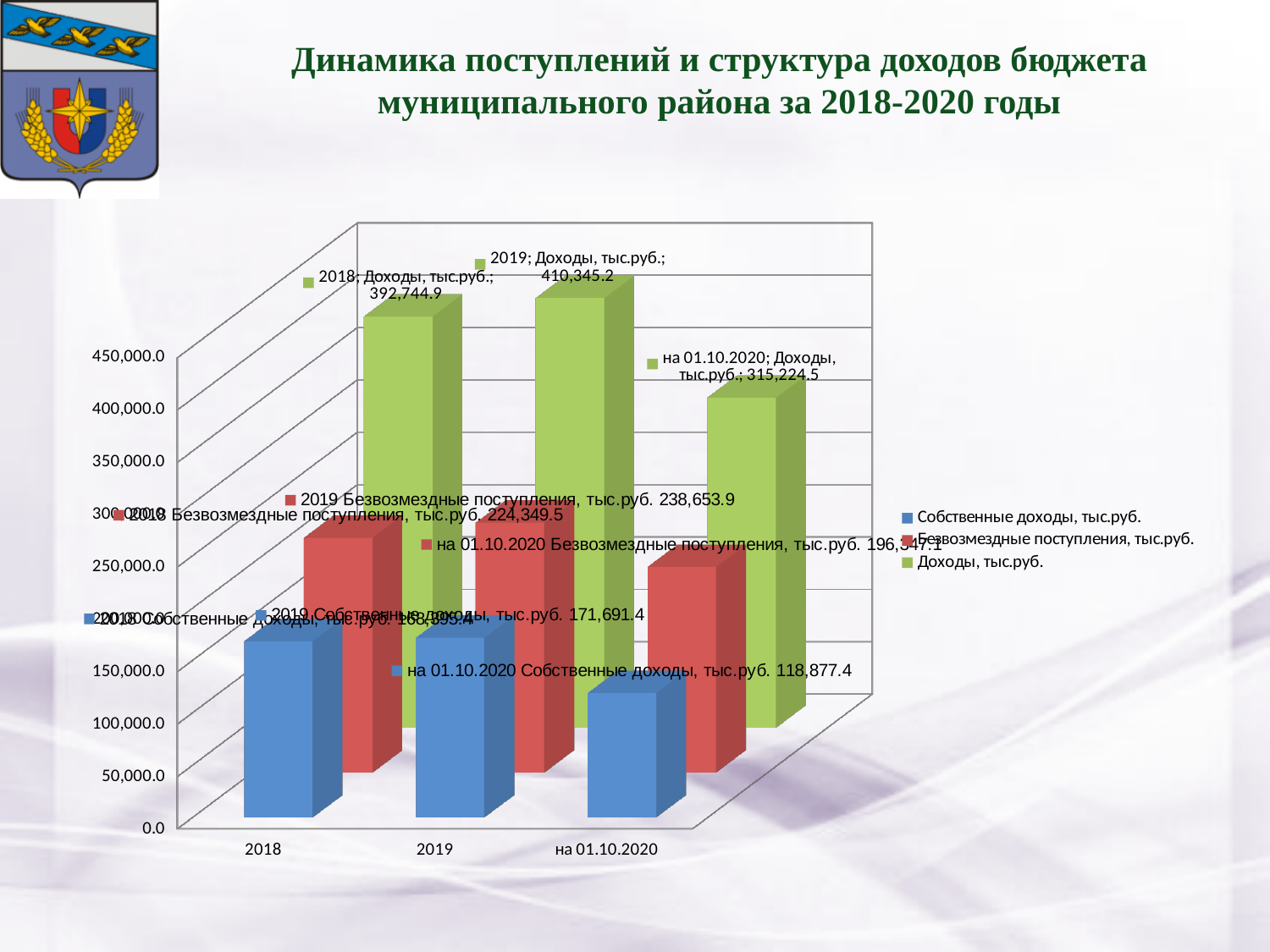
How many series does the legend list? 3 What is the value of Собственные доходы, тыс.руб. for на 01.10.2020? 118,877.4 What kind of chart is shown on the slide? bar chart What is the difference between Доходы, тыс.руб. in 2019 and in 2018? 17,600.3 Which period has the highest value of Доходы, тыс.руб.? 2019 Which period has the lowest value of Доходы, тыс.руб.? на 01.10.2020 What is the value of Безвозмездные поступления, тыс.руб. for 2018? 224,349.5 What is the value of Доходы, тыс.руб. for 2018? 392,744.9 What is the value of Доходы, тыс.руб. for 2019? 410,345.2 What is the value of Собственные доходы, тыс.руб. for 2019? 171,691.4 What is the value of Доходы, тыс.руб. for на 01.10.2020? 315,224.5 What is the value of Безвозмездные поступления, тыс.руб. for 2019? 238,653.9